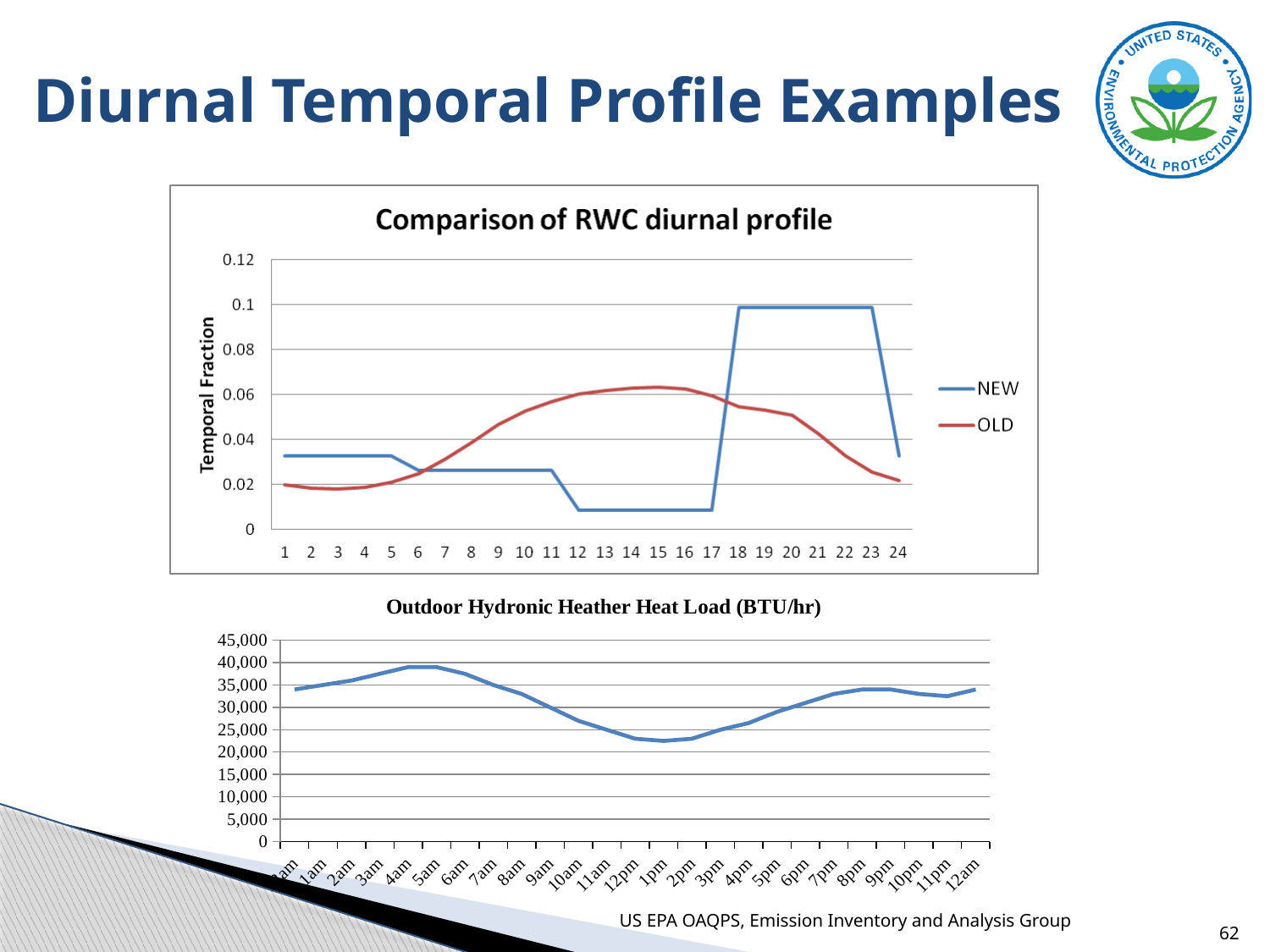
In the 'Comparison of RWC diurnal profile' chart, is the NEW value at hour 14 greater or less than 0.02? less How many hourly points are plotted along the x axis of the 'Comparison of RWC diurnal profile' chart? 24 In the 'Outdoor Hydronic Heather Heat Load (BTU/hr)' chart, do the values rise or fall from 5am to 1pm? fall In the 'Comparison of RWC diurnal profile' chart, which series has the higher value at hour 20, NEW or OLD? NEW In the 'Comparison of RWC diurnal profile' chart, which series has the higher value at hour 14, NEW or OLD? OLD What are the two series named in the legend of the 'Comparison of RWC diurnal profile' chart? NEW and OLD In the 'Outdoor Hydronic Heather Heat Load (BTU/hr)' chart, is the value at 1pm greater or less than 25,000? less What type of chart is the 'Comparison of RWC diurnal profile' chart? line chart What is the y-axis label of the 'Comparison of RWC diurnal profile' chart? Temporal Fraction How many series does the legend of the 'Comparison of RWC diurnal profile' chart list? 2 In the 'Comparison of RWC diurnal profile' chart, is the OLD value at hour 15 greater or less than 0.04? greater What type of chart is the 'Outdoor Hydronic Heather Heat Load (BTU/hr)' chart? line chart